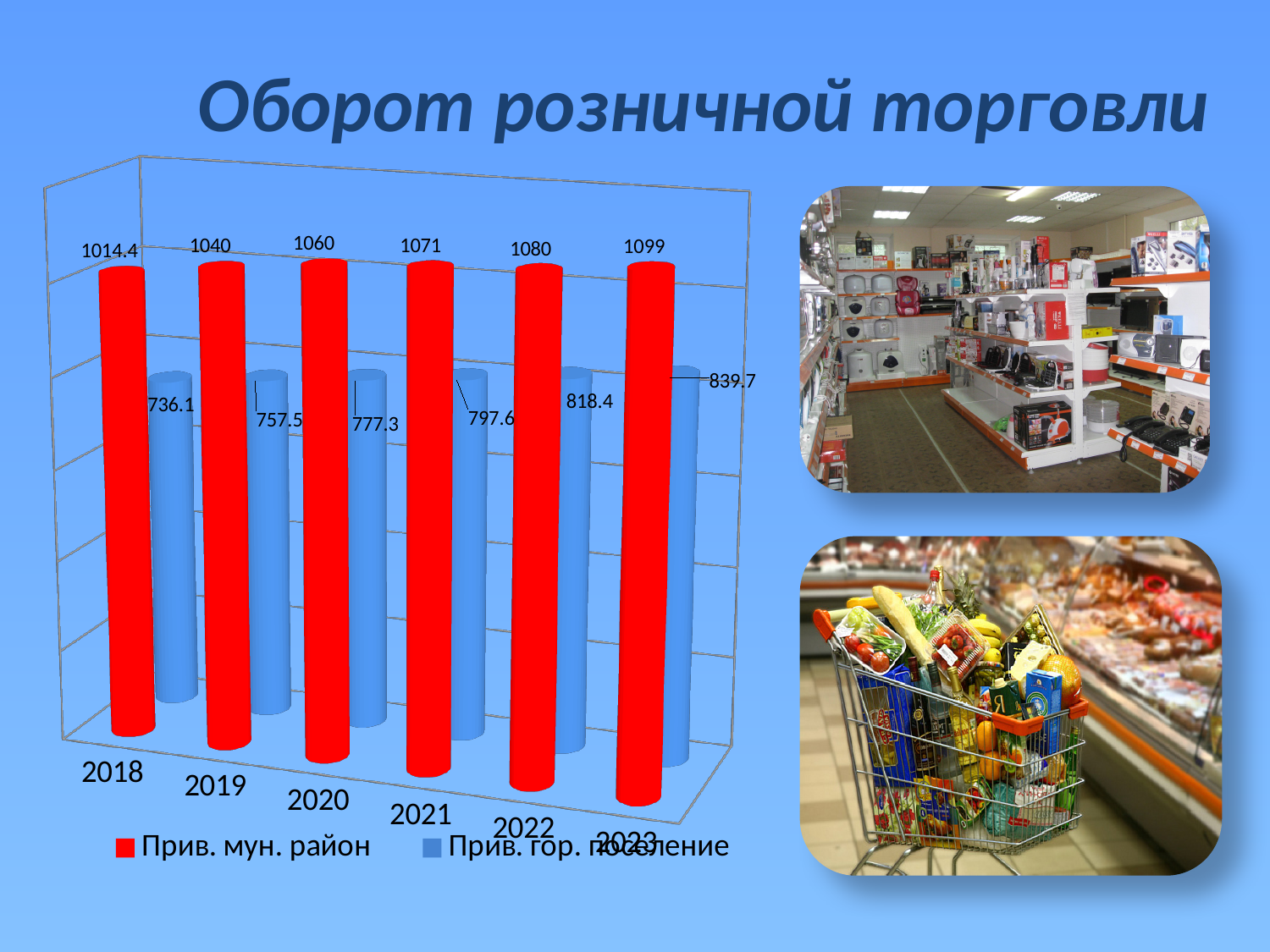
Do the values for Прив. гор. поселение rise or fall from 2018 to 2023? rise What is the difference between the Прив. мун. район and Прив. гор. поселение values in 2021? 273.4 What is the value for Прив. гор. поселение in 2023? 839.7 In which year is the value for Прив. гор. поселение lowest? 2018 How many years are shown on the x axis? 6 What is the value for Прив. мун. район in 2022? 1080 What is the value for Прив. гор. поселение in 2020? 777.3 What is the value for Прив. мун. район in 2018? 1014.4 Which is larger in 2019: Прив. мун. район or Прив. гор. поселение? Прив. мун. район How many series does the legend list? 2 What is the difference between the Прив. мун. район value in 2023 and in 2018? 84.6 In which year is the value for Прив. мун. район highest? 2023